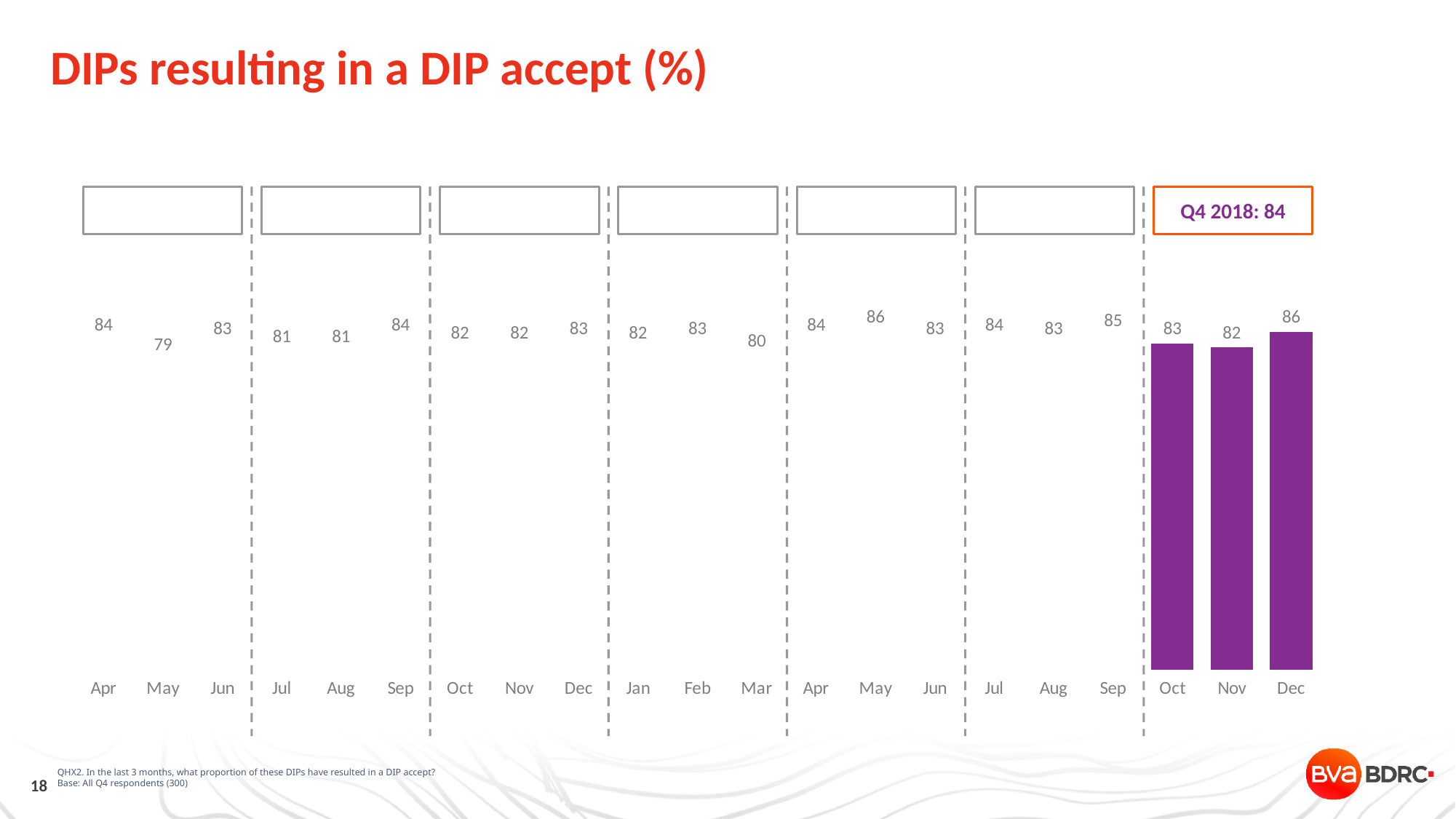
How many months are shown along the x axis? 21 What is the value for Mar? 80 What is the value for Nov in the Q4 2018 group? 82 What value is shown in the Q4 2018 box above the chart? 84 What kind of chart is this? Bar chart What is the value for Oct in the Q4 2018 group? 83 Which month has the lowest value on the chart? May (the first May, 79) What is the value for Jan? 82 What is the difference between the Dec and Nov values in the Q4 2018 group? 4 Which is larger, the value for Oct or the value for Dec in the Q4 2018 group? Dec What is the value for Feb? 83 What is the value for Dec in the Q4 2018 group? 86